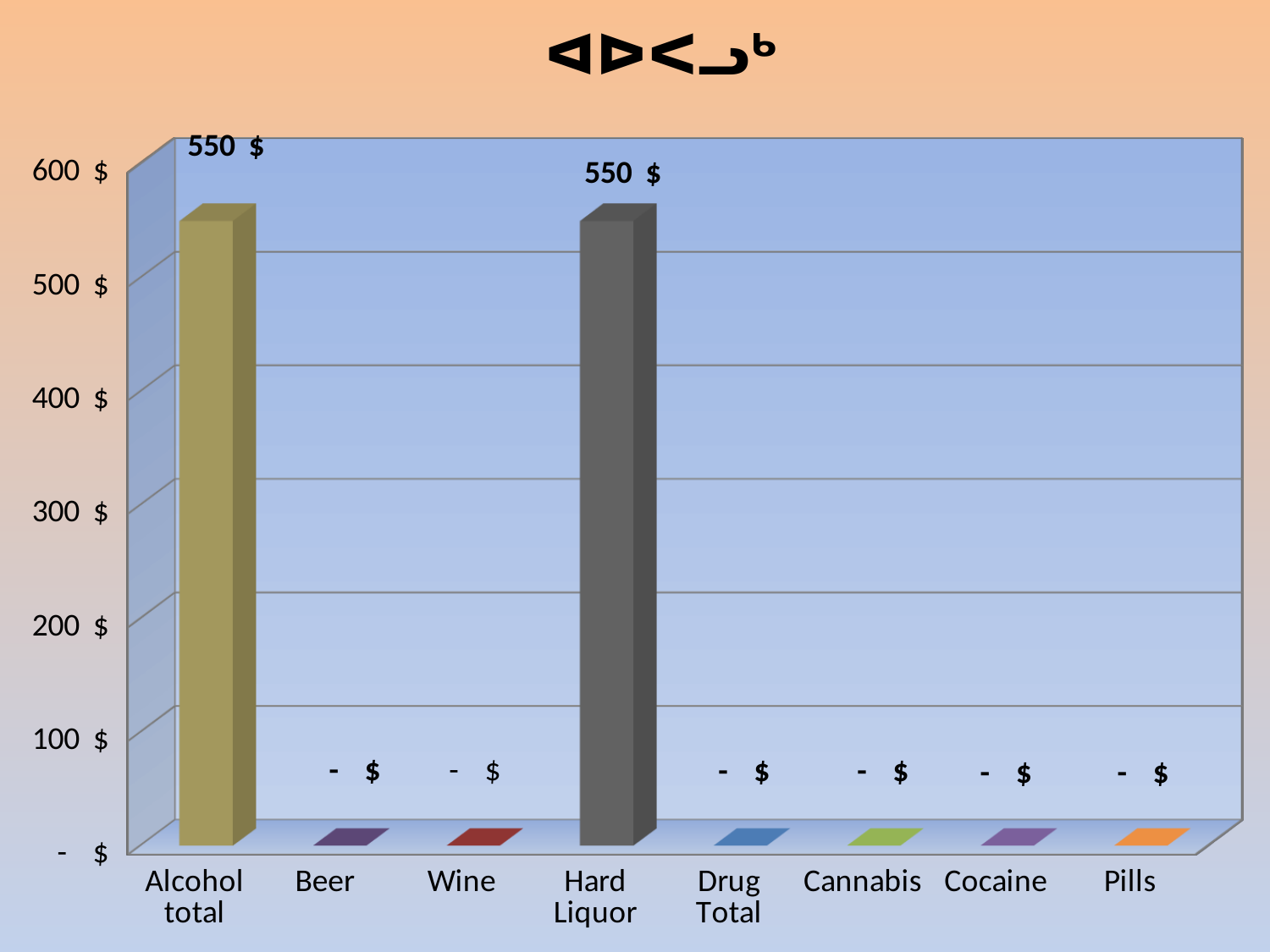
What is the value for Hard Liquor? 550 $ What is the value for Alcohol total? 550 $ What is the highest value shown on the vertical axis? 600 $ How many categories are shown on the x axis? 8 Which is larger, the value for Alcohol total or the value for Wine? Alcohol total What is the data label shown for Cannabis? - $ Which is larger, the value for Hard Liquor or the value for Drug Total? Hard Liquor What is the data label shown for Beer? - $ Is the value for Hard Liquor greater or less than 500 $? greater Is the value for Alcohol total greater or less than 600 $? less What is the difference between the value for Alcohol total and the value for Hard Liquor? 0 $ What kind of chart is shown on the slide? bar chart